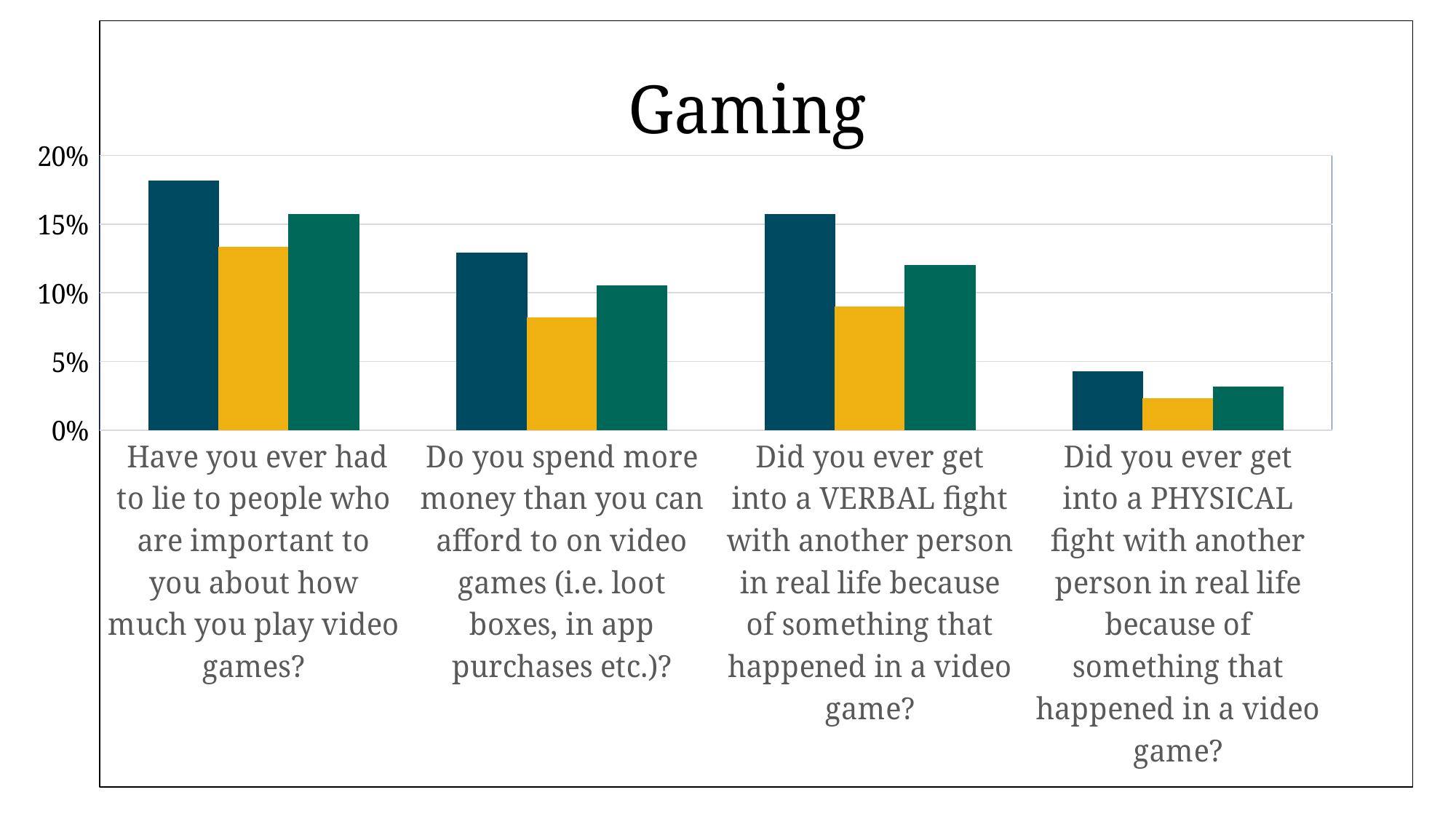
How many bars are plotted for each survey question? 3 Is the value of the yellow bar for "Do you spend more money than you can afford to on video games?" greater or less than 10%? less For the question about lying about how much you play video games, which bar is larger: the dark blue bar or the yellow bar? The dark blue bar Is the value of the dark blue bar for "Did you ever get into a PHYSICAL fight with another person in real life because of something that happened in a video game?" greater or less than 5%? less How many survey questions (categories) are shown along the x axis? 4 Is the value of the dark blue bar for "Have you ever had to lie to people who are important to you about how much you play video games?" greater or less than 15%? greater What is the title of the chart? Gaming Which is larger: the dark blue bar for the VERBAL fight question or the dark blue bar for the spending more money than you can afford question? The dark blue bar for the VERBAL fight question For which survey question are all three bars the lowest? Did you ever get into a PHYSICAL fight with another person in real life because of something that happened in a video game? What kind of chart is shown on the slide? Bar chart For which survey question is the dark blue bar the tallest? Have you ever had to lie to people who are important to you about how much you play video games?